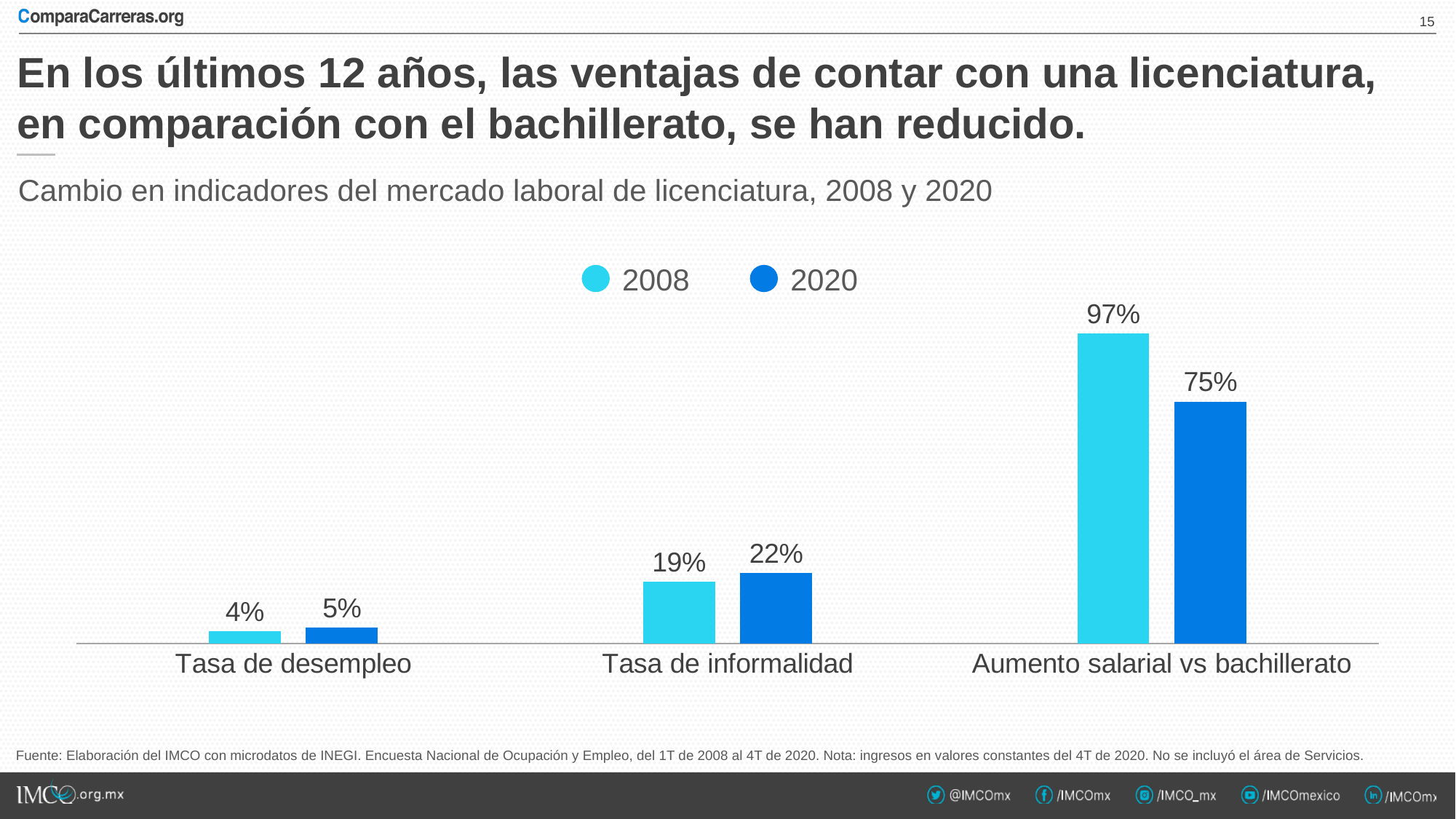
What is the difference between the 2020 and 2008 values for Tasa de informalidad? 3% How many series does the legend list? 2 What is the value for Aumento salarial vs bachillerato in 2008? 97% What is the value for Tasa de informalidad in 2020? 22% Which category has the highest value in 2020? Aumento salarial vs bachillerato What is the difference between the 2008 and 2020 values for Aumento salarial vs bachillerato? 22% Which is larger for Tasa de informalidad, the 2008 value or the 2020 value? 2020 What is the value for Tasa de desempleo in 2020? 5% How many categories are shown on the x axis? 3 What kind of chart is shown on the slide? Bar chart Which category has the lowest value in 2008? Tasa de desempleo What is the value for Tasa de desempleo in 2008? 4%